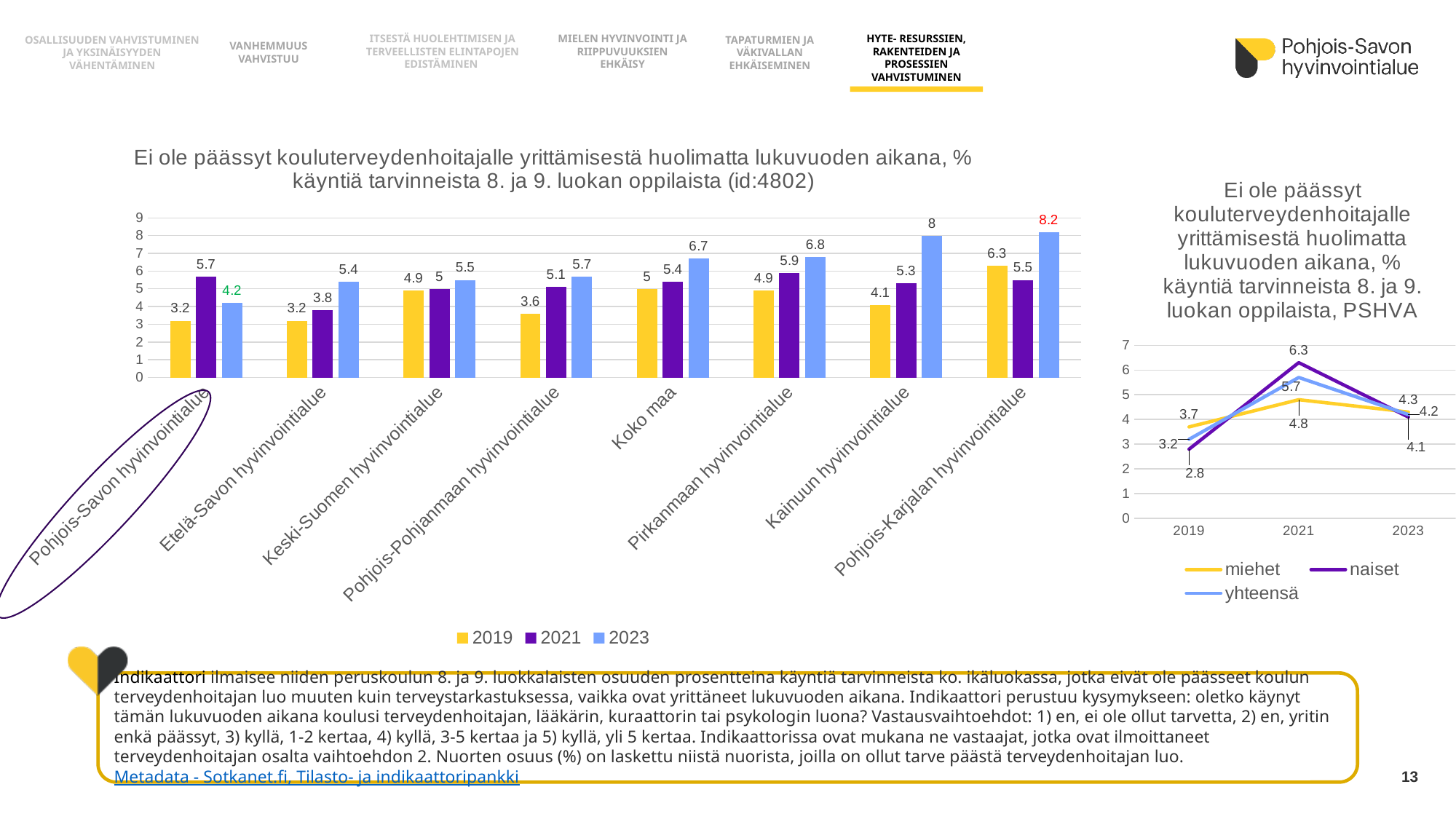
In the left bar chart, what is the 2023 value for Pohjois-Savon hyvinvointialue? 4.2 In the left bar chart, which category has the highest 2023 value? Pohjois-Karjalan hyvinvointialue How many series does the legend of the left bar chart list? 3 In the left bar chart, which category has the lowest 2021 value? Etelä-Savon hyvinvointialue How many categories are shown on the x axis of the left bar chart? 8 In the right line chart, which series has the highest value in 2023? miehet In the left bar chart, what is the 2019 value for Pohjois-Karjalan hyvinvointialue? 6.3 In the left bar chart, which is larger for Koko maa: the 2021 value or the 2023 value? 2023 What kind of chart is the chart on the right of the slide? Line chart In the right line chart, what is the value for naiset in 2021? 6.3 In the right line chart, what is the difference between miehet and naiset in 2019? 0.9 In the left bar chart, what is the difference between the 2023 and 2019 values for Kainuun hyvinvointialue? 3.9